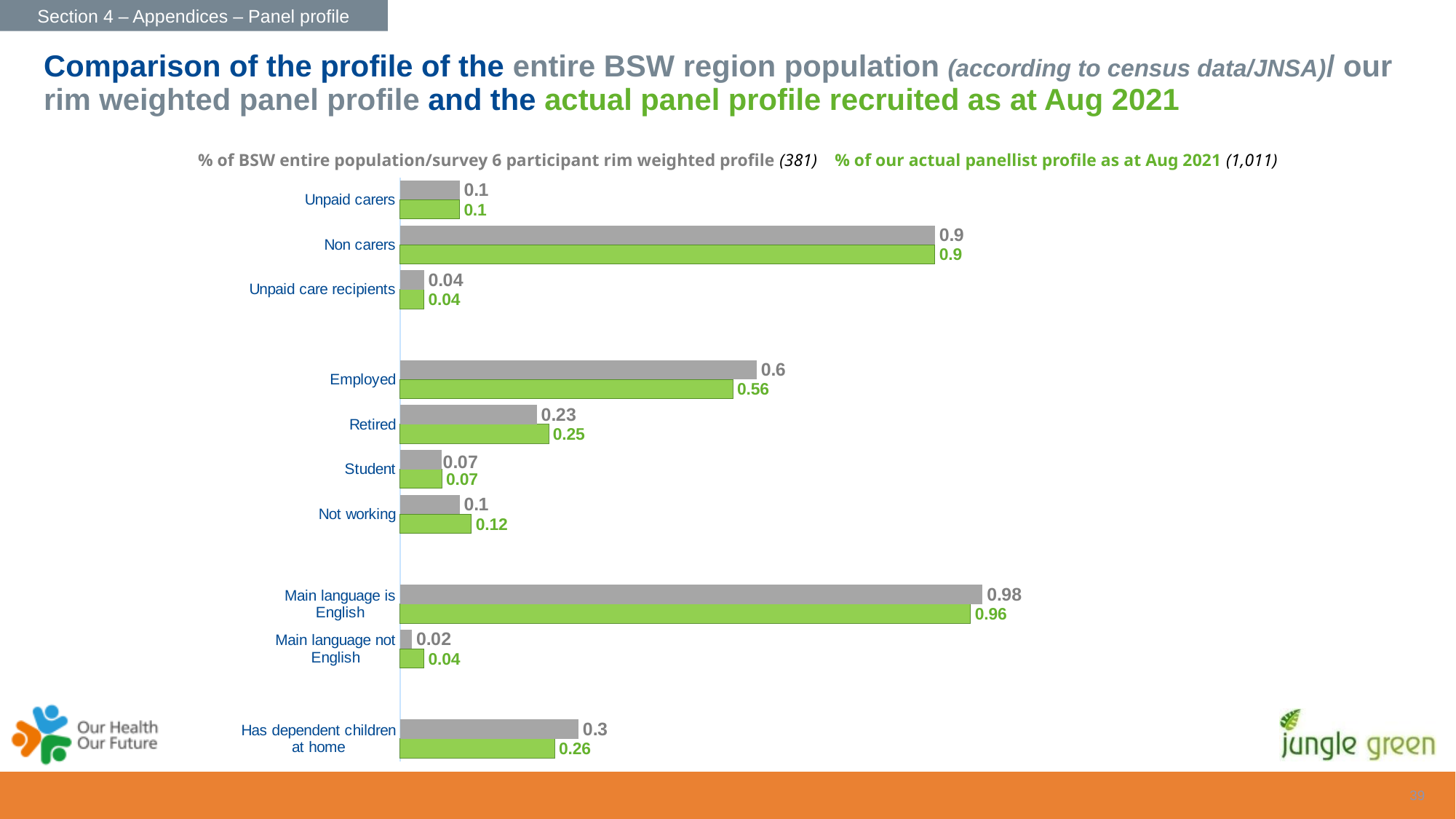
For Not working, which series has the larger value: the rim weighted profile or the actual panellist profile as at Aug 2021? actual panellist profile as at Aug 2021 Which category has the highest value in the BSW entire population/survey 6 participant rim weighted profile series? Main language is English How many categories are plotted in the chart? 10 What kind of chart is shown on the slide? bar chart What is the value for Retired in the BSW entire population/survey 6 participant rim weighted profile series? 0.23 What is the difference between the rim weighted profile value and the actual panellist profile value for Main language is English? 0.02 What colour are the bars for the actual panellist profile as at Aug 2021 series? green How many series does the chart's legend list? 2 What is the value for Employed in the actual panellist profile as at Aug 2021 series? 0.56 Which category has the lowest value in the BSW entire population/survey 6 participant rim weighted profile series? Main language not English What is the difference between the rim weighted profile value and the actual panellist profile value for Has dependent children at home? 0.04 What is the value for Main language not English in the actual panellist profile as at Aug 2021 series? 0.04